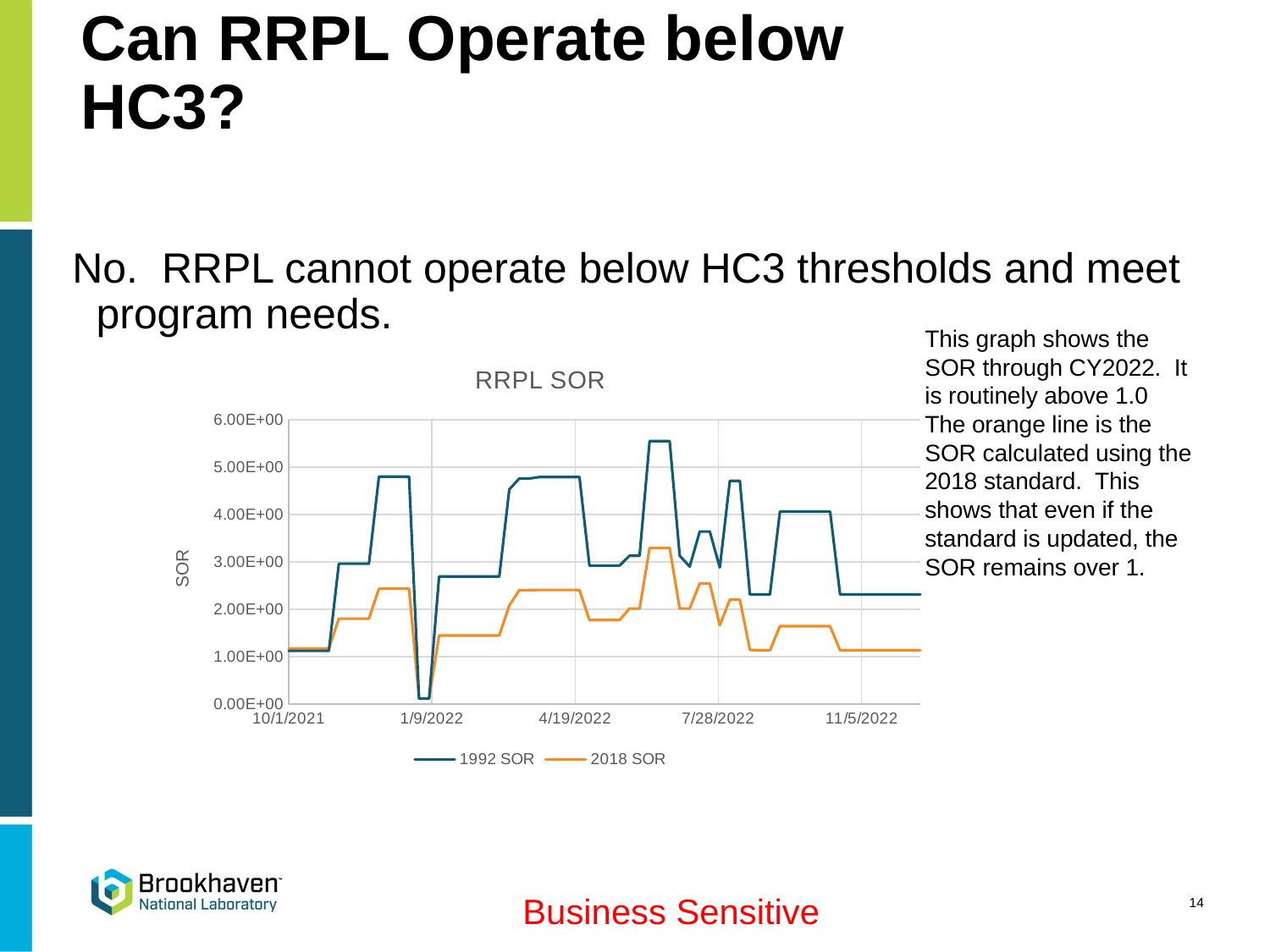
Is the 2018 SOR value at 11/5/2022 greater or less than 2.00E+00? less Which series has the higher values across the chart, 1992 SOR or 2018 SOR? 1992 SOR Is the highest value reached by the 2018 SOR line greater or less than 4.00E+00? less What is the title of the chart? RRPL SOR What kind of chart is shown on the slide? line chart Is the 1992 SOR value at 11/5/2022 greater or less than 3.00E+00? less Which series is drawn as the orange line? 2018 SOR Which series has the higher value at 7/28/2022, 1992 SOR or 2018 SOR? 1992 SOR How many series does the legend of the RRPL SOR chart list? 2 How many date labels are shown on the x axis? 5